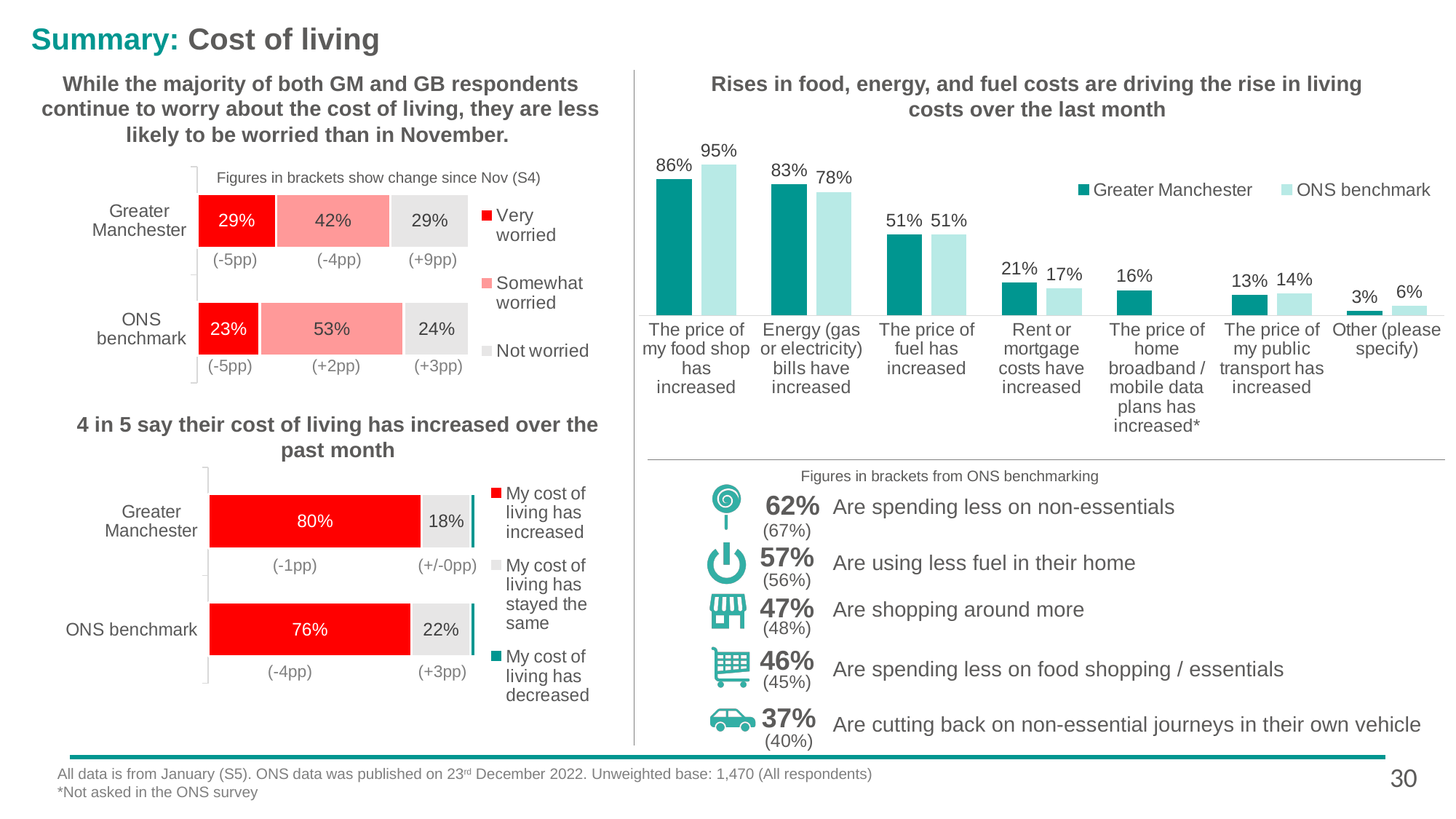
What kind of chart is the chart titled '4 in 5 say their cost of living has increased over the past month'? Stacked bar chart In the chart titled 'Rises in food, energy, and fuel costs are driving the rise in living costs over the last month', how many series does the legend list? 2 In the chart titled 'Rises in food, energy, and fuel costs are driving the rise in living costs over the last month', which category has the highest ONS benchmark value? The price of my food shop has increased In the top-left stacked bar chart about worry over the cost of living, what percentage of Greater Manchester respondents are 'Somewhat worried'? 42% In the chart titled 'Rises in food, energy, and fuel costs are driving the rise in living costs over the last month', which category has the lowest Greater Manchester value? Other (please specify) In the top-left stacked bar chart about worry over the cost of living, what percentage of ONS benchmark respondents are 'Very worried'? 23% In the chart titled 'Rises in food, energy, and fuel costs are driving the rise in living costs over the last month', what is the difference between the ONS benchmark and Greater Manchester values for 'The price of my food shop has increased'? 9 percentage points In the chart titled '4 in 5 say their cost of living has increased over the past month', what percentage of ONS benchmark respondents say their cost of living has increased? 76% In the chart titled 'Rises in food, energy, and fuel costs are driving the rise in living costs over the last month', how many categories are shown on the x axis? 7 In the chart titled 'Rises in food, energy, and fuel costs are driving the rise in living costs over the last month', what is the Greater Manchester value for 'The price of my food shop has increased'? 86% In the chart titled 'Rises in food, energy, and fuel costs are driving the rise in living costs over the last month', is the Greater Manchester value for 'Rent or mortgage costs have increased' larger or smaller than the ONS benchmark value? larger In the chart titled 'Rises in food, energy, and fuel costs are driving the rise in living costs over the last month', what is the ONS benchmark value for 'Energy (gas or electricity) bills have increased'? 78%